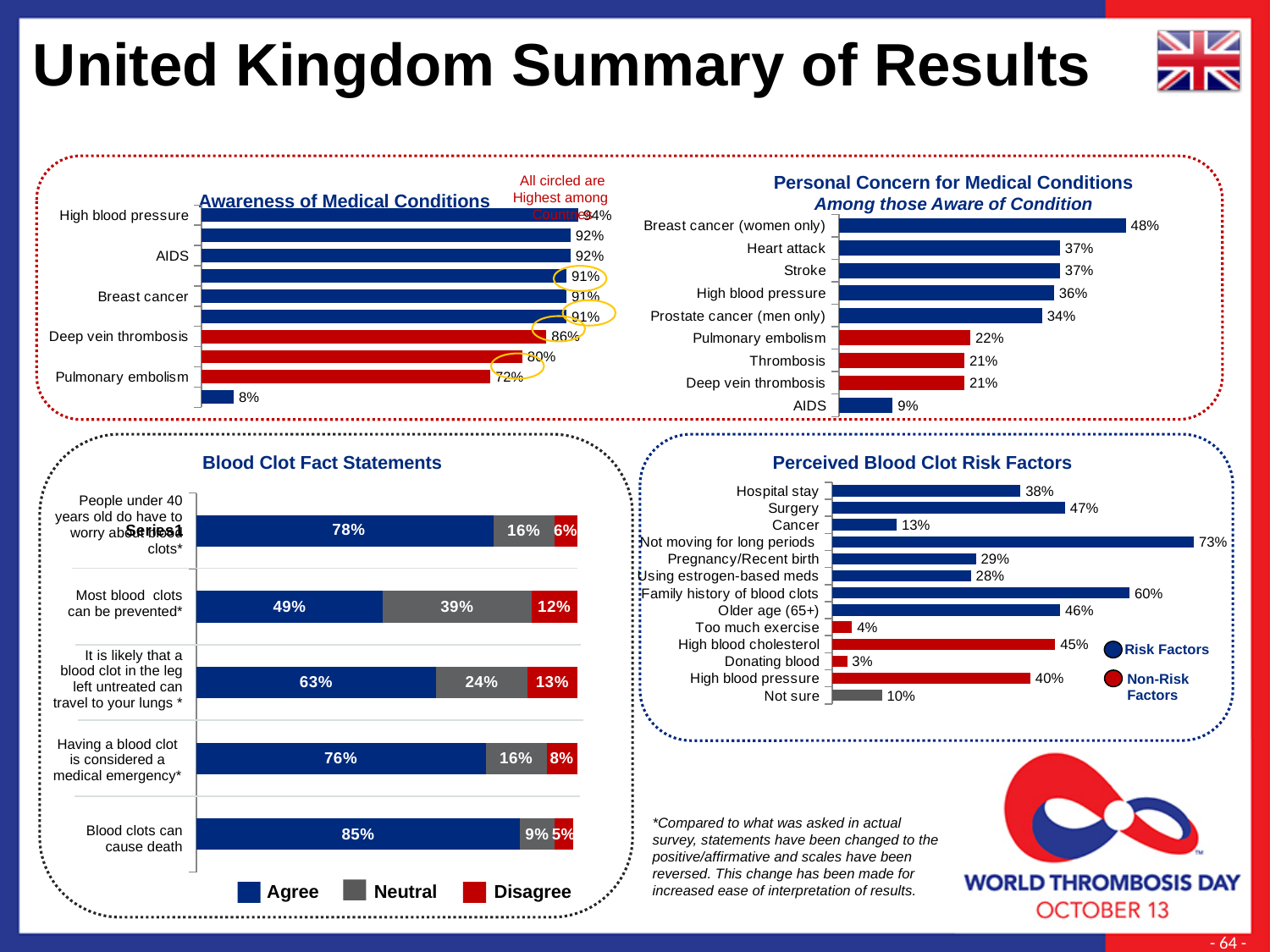
In the Perceived Blood Clot Risk Factors chart, what is the value for Donating blood? 3% In the Perceived Blood Clot Risk Factors chart, which is larger: Surgery or Hospital stay? Surgery What kind of chart is the Blood Clot Fact Statements chart? Stacked bar chart In the Awareness of Medical Conditions chart, what is the value for Pulmonary embolism? 72% How many conditions are listed in the Personal Concern for Medical Conditions chart? 9 In the Blood Clot Fact Statements chart, what percentage agree that blood clots can cause death? 85% How many series does the legend of the Blood Clot Fact Statements chart list? 3 In the Blood Clot Fact Statements chart, what is the Neutral value for 'Most blood clots can be prevented'? 39% In the Personal Concern for Medical Conditions chart, which condition has the lowest value? AIDS In the Perceived Blood Clot Risk Factors chart, which factor has the highest value? Not moving for long periods In the Personal Concern for Medical Conditions chart, what is the difference between Heart attack and Pulmonary embolism? 15% In the Personal Concern for Medical Conditions chart, what is the value for Breast cancer (women only)? 48%